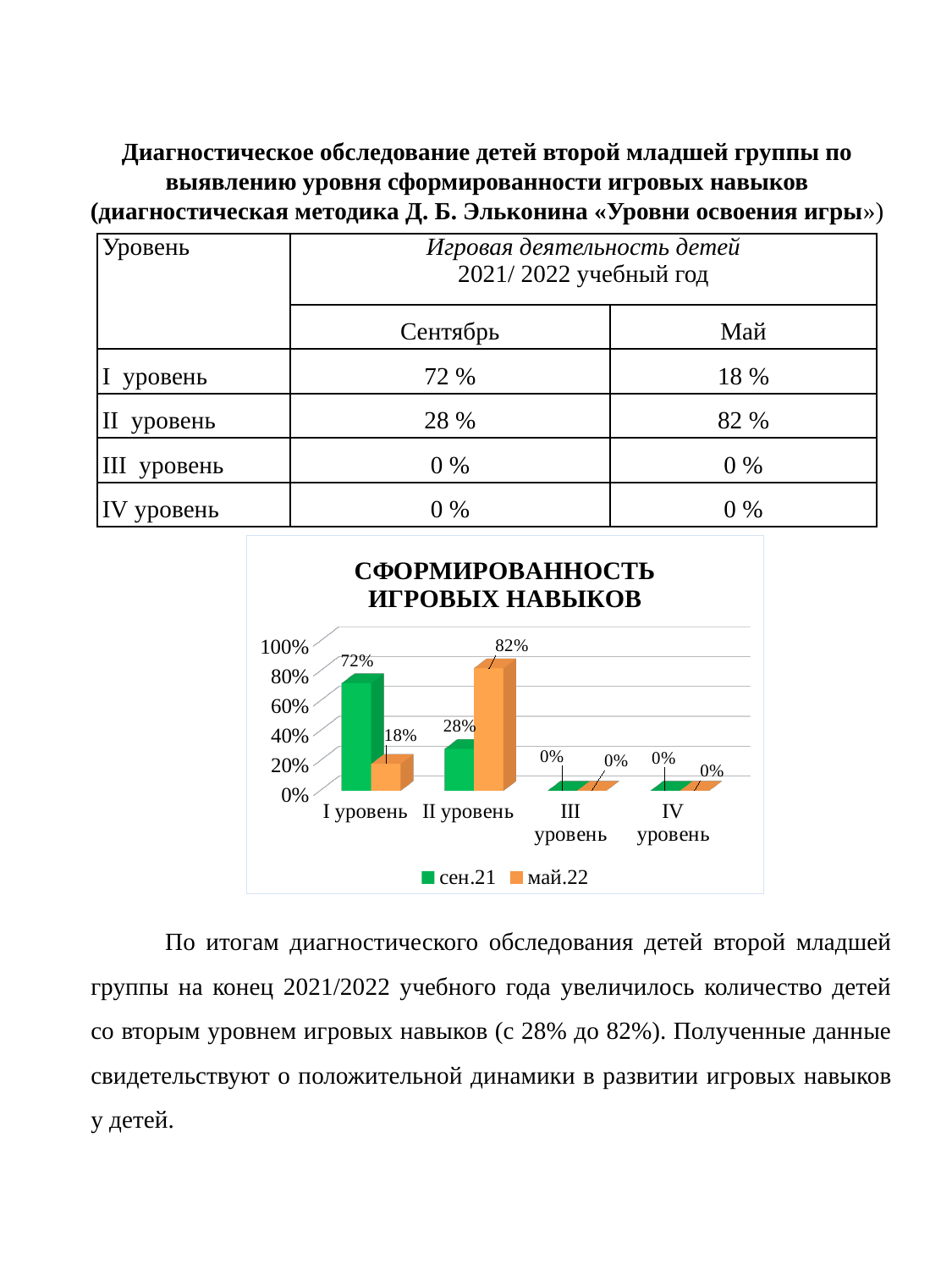
What is the title of the chart? СФОРМИРОВАННОСТЬ ИГРОВЫХ НАВЫКОВ How many series does the legend list? 2 What is the value for I уровень in the сен.21 series? 72% What is the value for II уровень in the май.22 series? 82% What is the difference between the май.22 and сен.21 values for II уровень? 54% What kind of chart is shown? bar chart Which is larger for I уровень: the сен.21 value or the май.22 value? сен.21 How many categories are shown on the x axis? 4 Which category has the highest value in the май.22 series? II уровень Which category has the highest value in the сен.21 series? I уровень What is the value for I уровень in the май.22 series? 18% What colour represents the май.22 series? orange